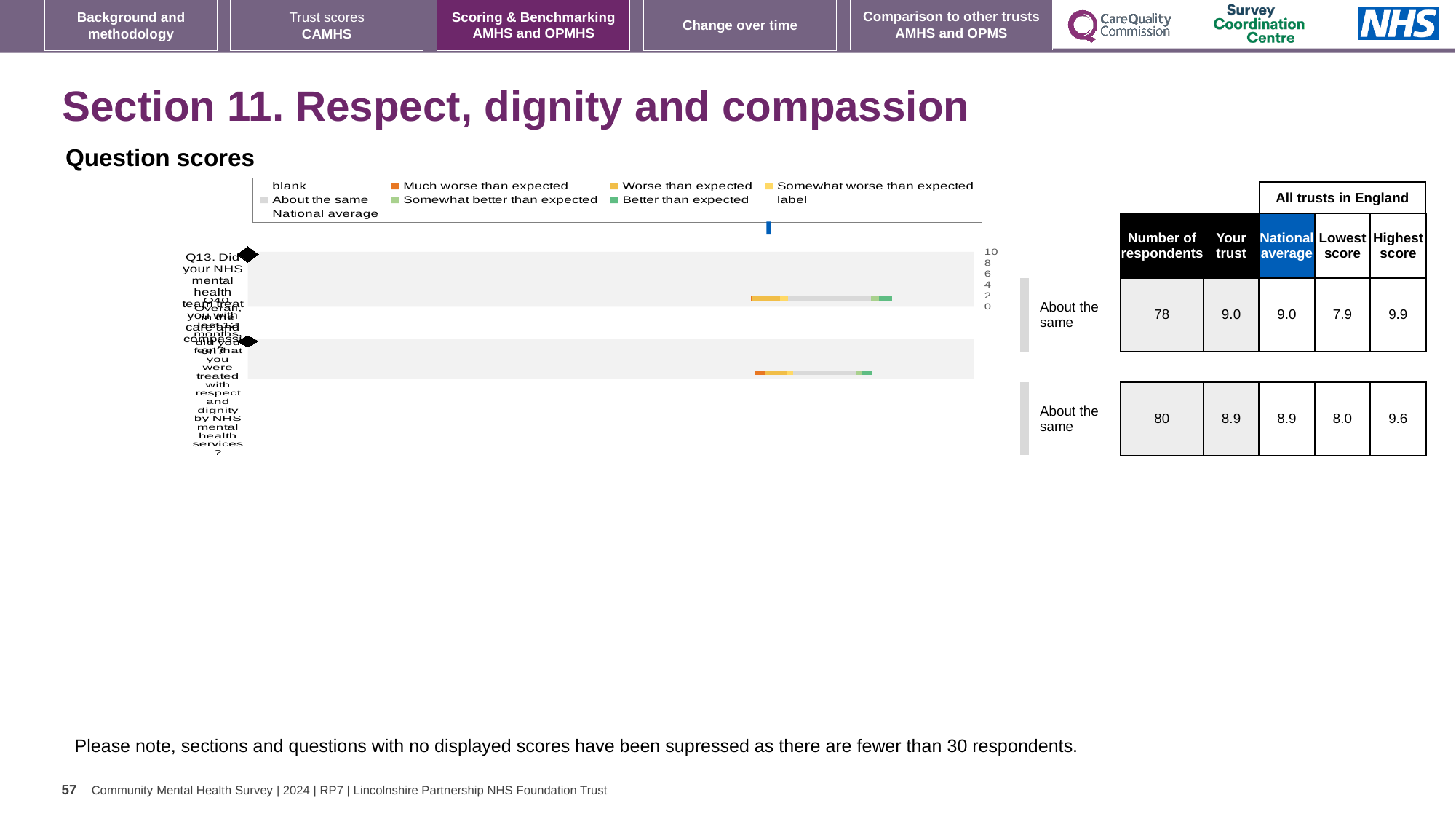
What is the lowest score across all trusts in England for the bottom question row? 8.0 What is the number of respondents for the top question row? 78 What is the highest score across all trusts in England for the top question row? 9.9 What is the 'Your trust' score for the top question row? 9.0 How many question rows are plotted in the chart? 2 What is the 'Your trust' score for the bottom question row? 8.9 What is the difference between the highest and lowest score for the top question row? 2.0 What is the number of respondents for the bottom question row? 80 What benchmark category is shown for both question rows? About the same What kind of chart is shown under 'Question scores'? bar chart What is the national average for the bottom question row? 8.9 Which question row has more respondents, the top or the bottom? bottom